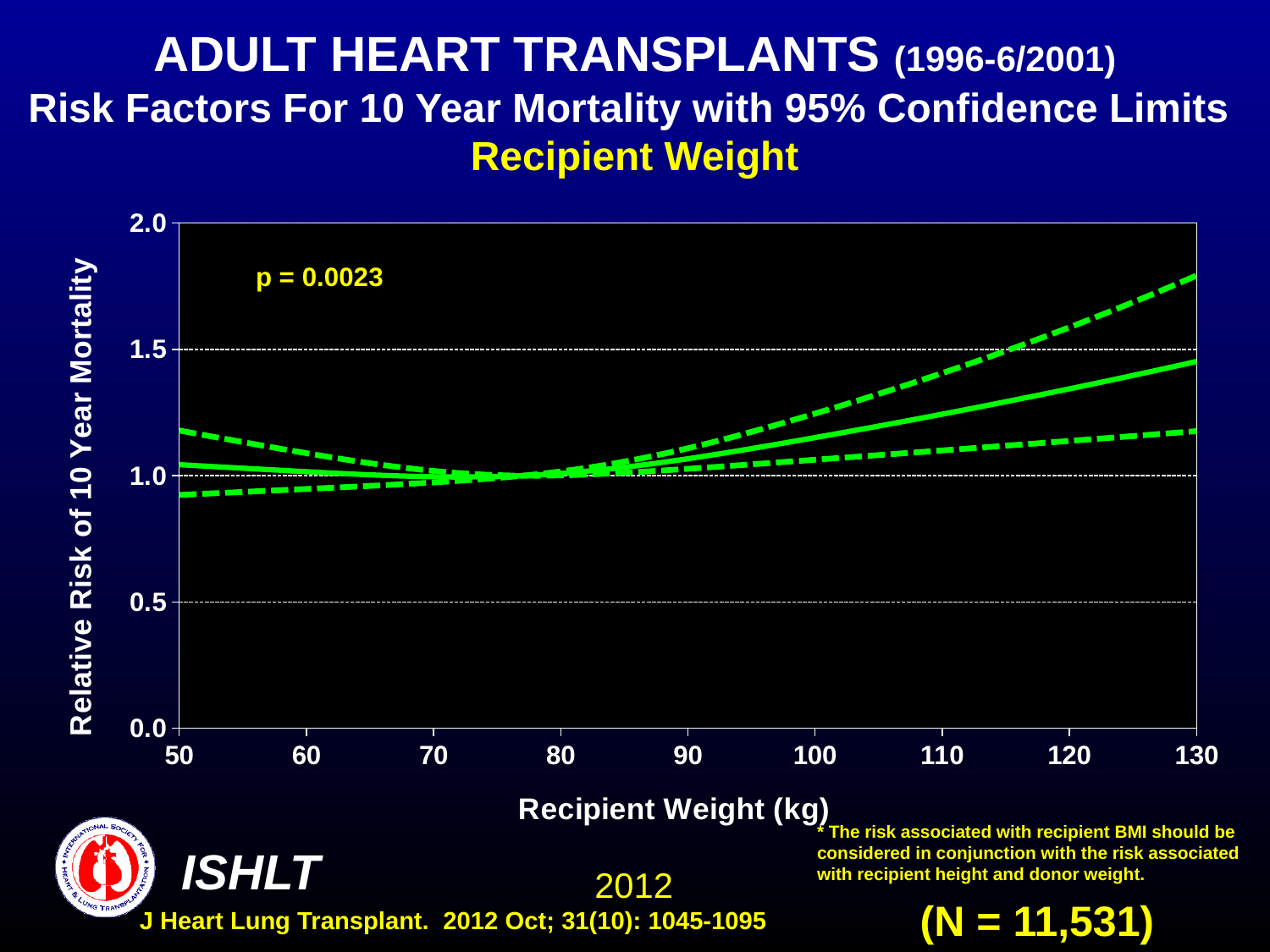
How many tick labels are shown on the x axis? 9 Is the value of the lower dashed confidence limit at 50 kg greater or less than 1.0? less What is the sample size (N) shown on the slide? N = 11,531 What kind of chart is shown on the slide? line chart Does the solid relative risk line rise or fall between 80 kg and 130 kg? rise Is the value of the upper dashed confidence limit at 50 kg greater or less than 1.0? greater What is the label of the y axis? Relative Risk of 10 Year Mortality Is the value of the upper dashed confidence limit at 130 kg greater or less than 1.5? greater How many lines are plotted on the chart? 3 What is the p-value printed on the chart? p = 0.0023 What is the label of the x axis? Recipient Weight (kg)